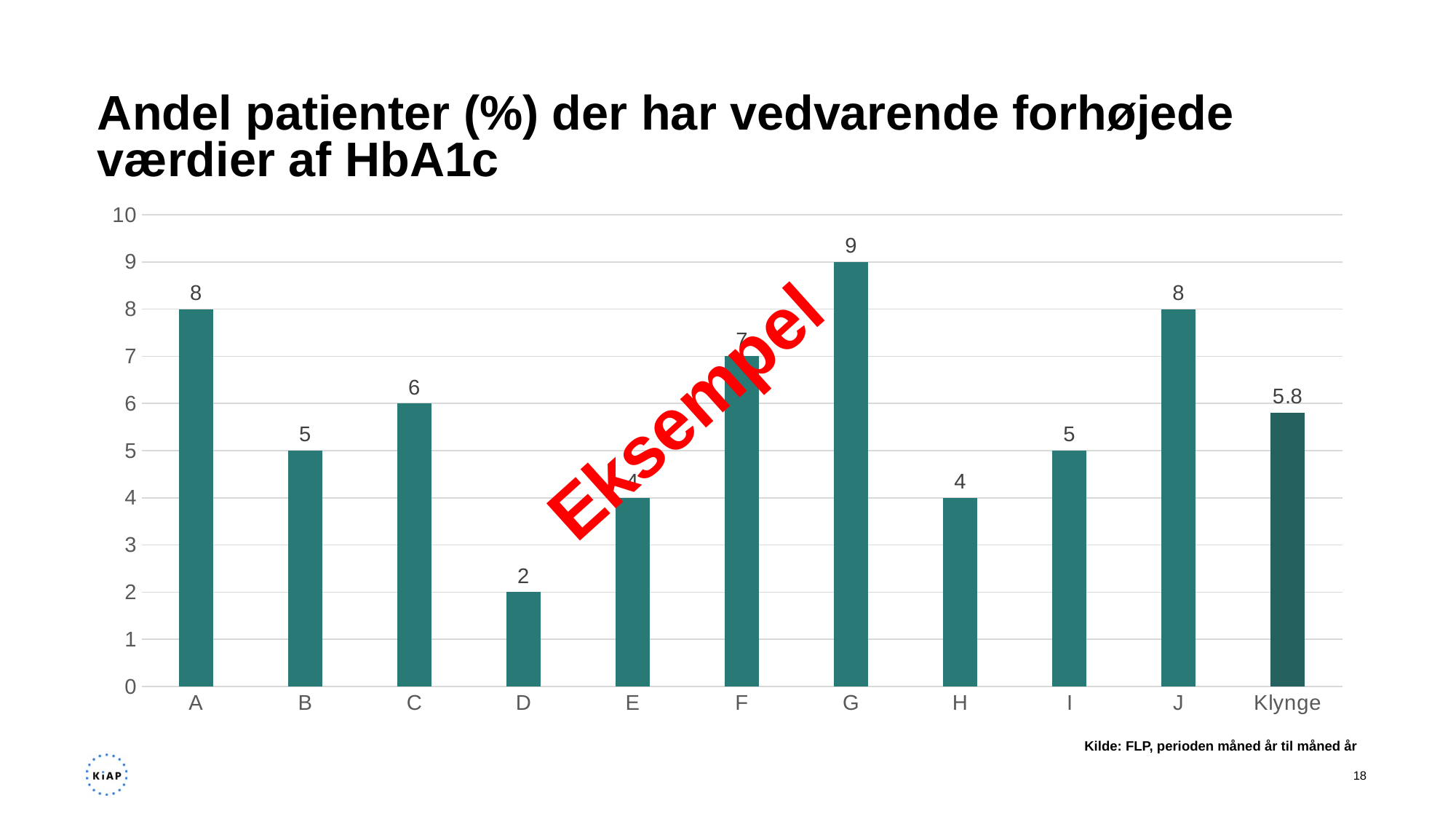
How many categories are shown on the x axis? 11 Is the value for H greater or less than 5? less What kind of chart is shown on the slide? bar chart Which has the larger value, B or C? C What is the value for category G? 9 What is the value for category D? 2 What is the difference between the values for G and D? 7 Which category has the highest value? G What is the value for Klynge? 5.8 What is the value for category F? 7 What is the value for category A? 8 Which category has the lowest value? D